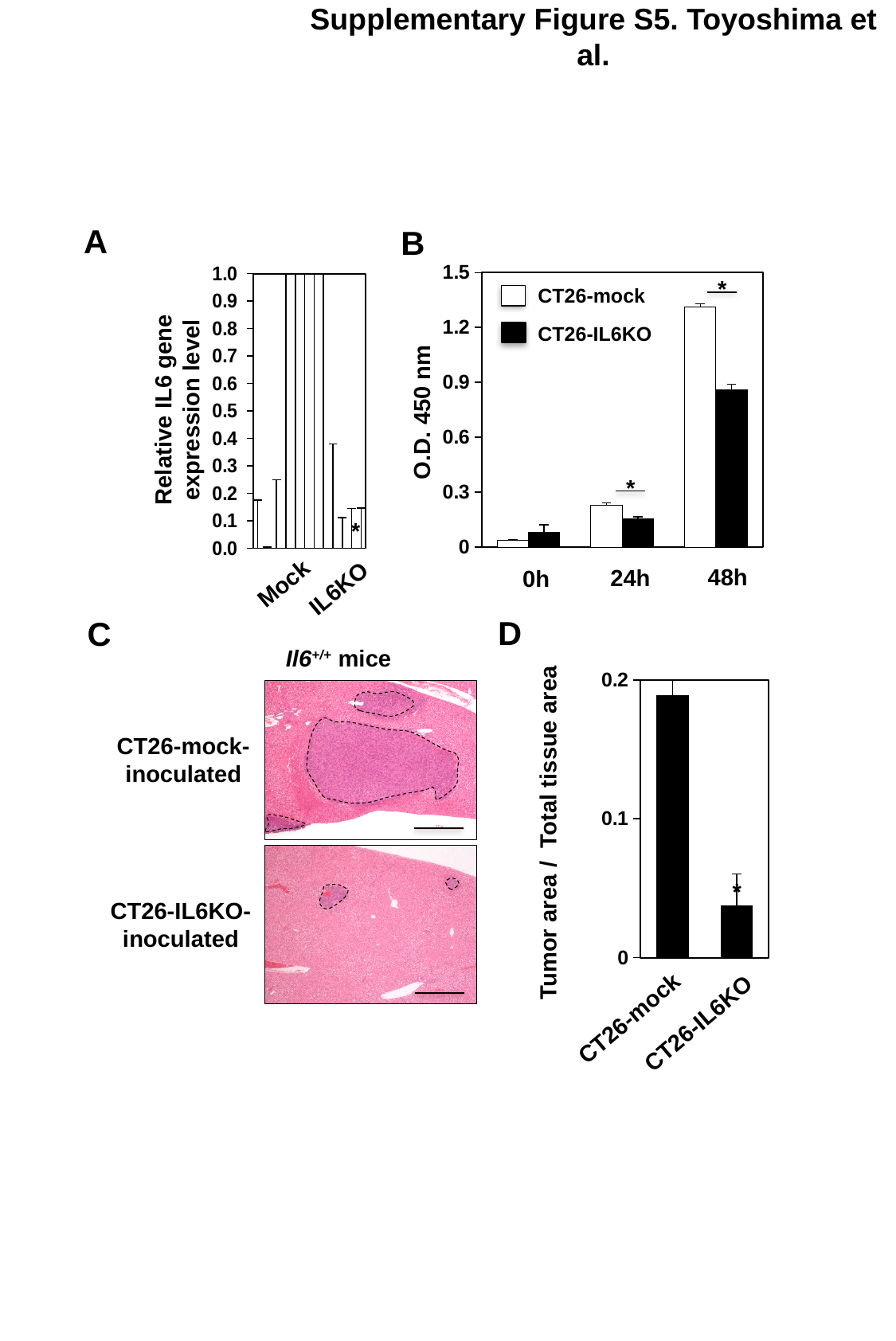
In chart B (O.D. 450 nm), does the CT26-mock series rise or fall from 0h to 48h? rise In chart B (O.D. 450 nm), is the value for CT26-IL6KO at 48h greater or less than 0.9? less What kind of chart is chart D (Tumor area / Total tissue area)? bar chart In chart B (O.D. 450 nm), how many series does the legend list? 2 In chart B (O.D. 450 nm), what are the two series named in the legend? CT26-mock and CT26-IL6KO In chart B (O.D. 450 nm), at 48h which series has the larger value, CT26-mock or CT26-IL6KO? CT26-mock In chart B (O.D. 450 nm), how many time points are shown on the x axis? 3 In chart D (Tumor area / Total tissue area), is the value for CT26-mock greater or less than 0.1? greater In chart B (O.D. 450 nm), is the value for CT26-mock at 24h greater or less than 0.3? less In chart B (O.D. 450 nm), which series and time point has the highest bar? CT26-mock at 48h In chart D (Tumor area / Total tissue area), which category has the lower value, CT26-mock or CT26-IL6KO? CT26-IL6KO